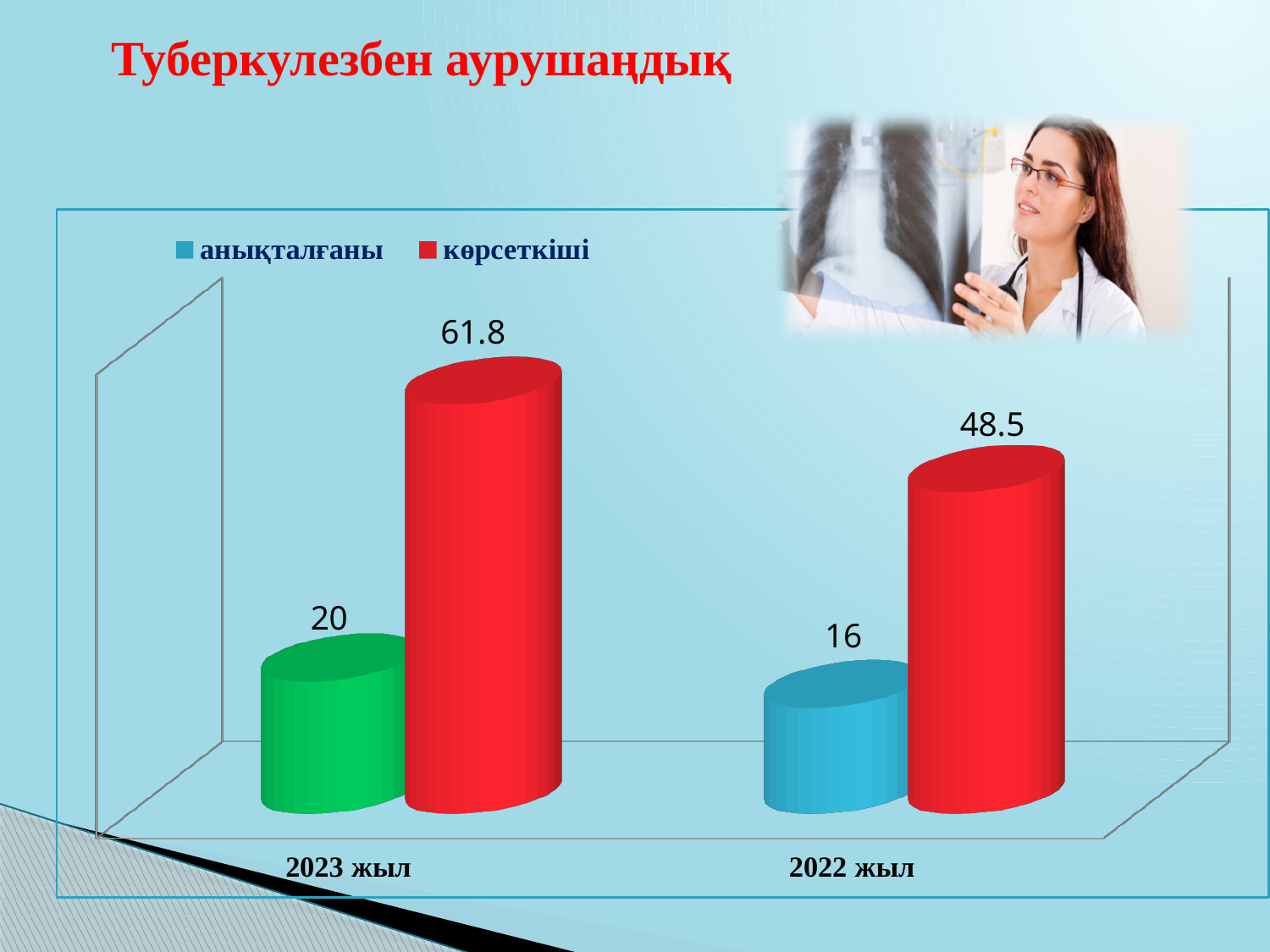
What is the difference between the анықталғаны values for 2023 жыл and 2022 жыл? 4 How many series does the chart legend list? 2 What is the value of көрсеткіші for 2022 жыл? 48.5 Which year has the higher көрсеткіші value? 2023 жыл How many categories (years) are shown on the x axis of the chart? 2 What is the value of анықталғаны for 2022 жыл? 16 Is the анықталғаны value for 2023 жыл larger or smaller than the анықталғаны value for 2022 жыл? larger What is the difference between the көрсеткіші values for 2023 жыл and 2022 жыл? 13.3 What is the value of көрсеткіші for 2023 жыл? 61.8 What is the value of анықталғаны for 2023 жыл? 20 What type of chart is shown on the slide? bar chart Which year has the lower анықталғаны value? 2022 жыл